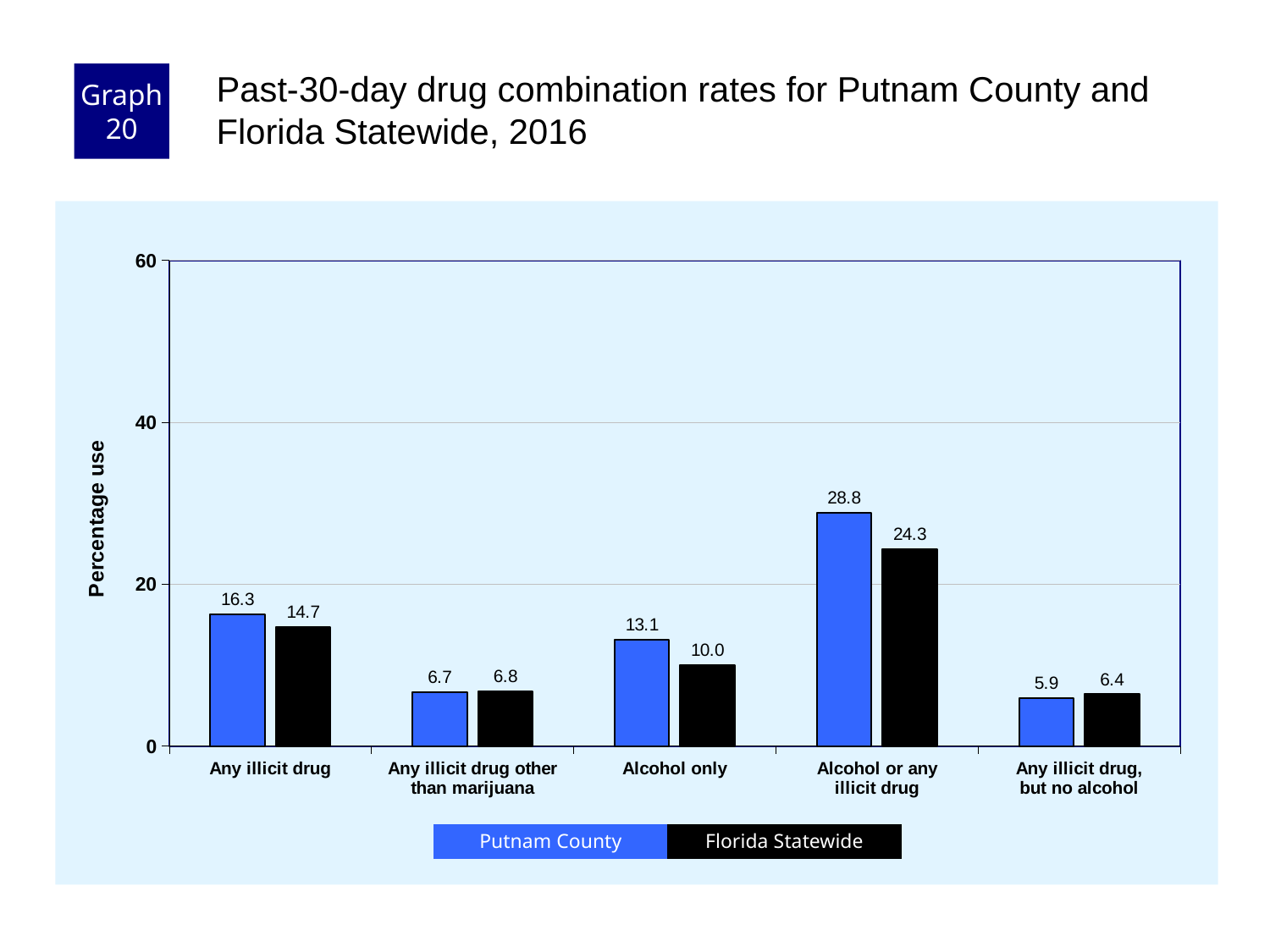
What is the Florida Statewide value for Alcohol only? 10.0 What is the Putnam County value for Any illicit drug, but no alcohol? 5.9 What is the Putnam County value for Alcohol or any illicit drug? 28.8 Which is larger for Any illicit drug: the Putnam County value or the Florida Statewide value? Putnam County Which category has the highest Florida Statewide value? Alcohol or any illicit drug What kind of chart is shown on the slide? bar chart Is the Putnam County value for Alcohol or any illicit drug greater or less than 20? greater What is the label of the y axis? Percentage use How many categories are shown on the x axis? 5 Which category has the lowest Putnam County value? Any illicit drug, but no alcohol What is the difference between the Putnam County and Florida Statewide values for Alcohol or any illicit drug? 4.5 How many series does the legend list? 2